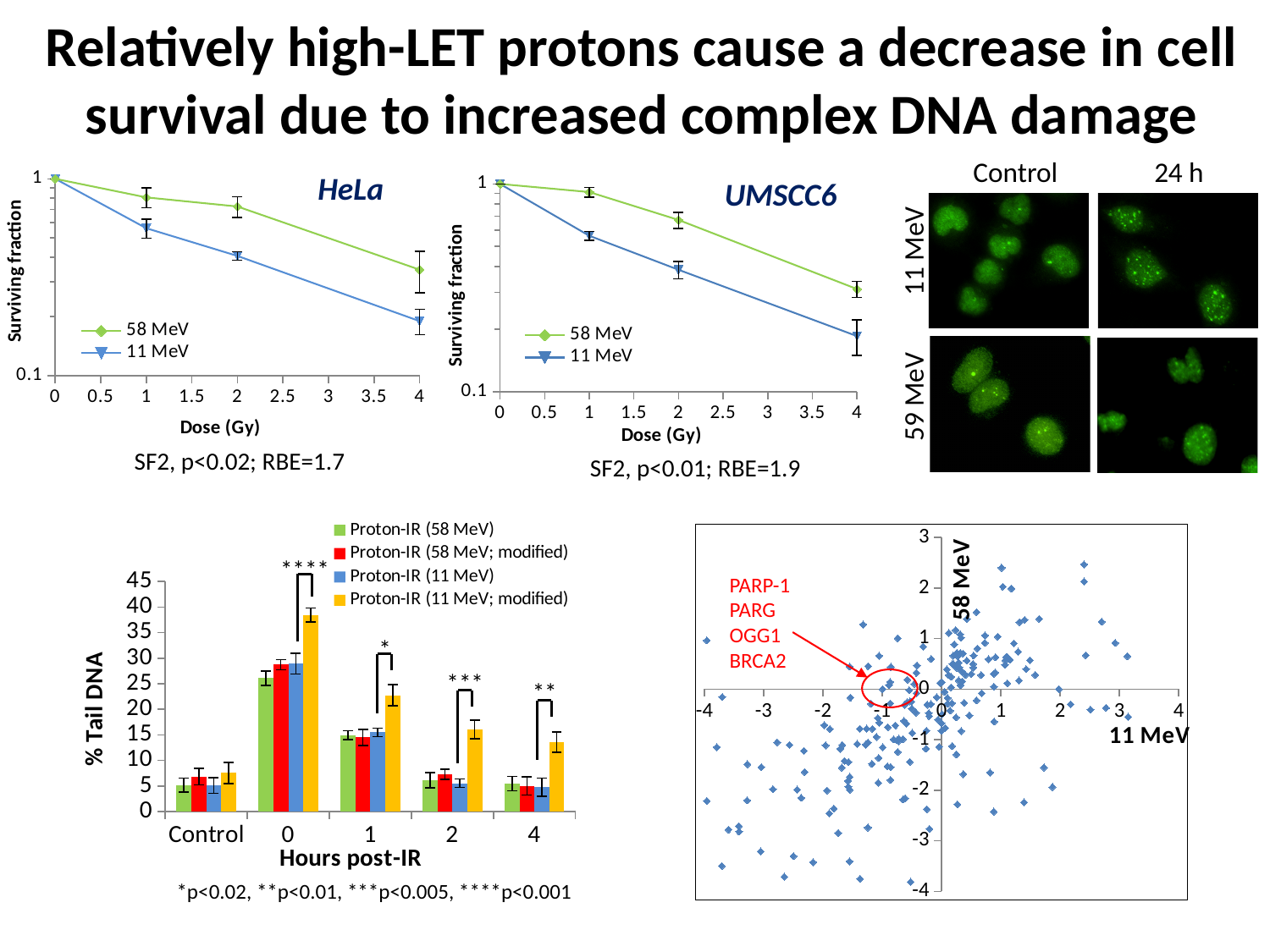
In the UMSCC6 chart, at a dose of 2 Gy, which series has the lower surviving fraction, 58 MeV or 11 MeV? 11 MeV In the % Tail DNA bar chart, which series has the highest bar at 0 hours post-IR? Proton-IR (11 MeV; modified) What kind of chart is the HeLa chart at the top left? Line chart In the HeLa chart, at a dose of 4 Gy, which series has the higher surviving fraction, 58 MeV or 11 MeV? 58 MeV How many series does the legend of the % Tail DNA bar chart list? 4 In the UMSCC6 chart, is the surviving fraction for 11 MeV at 4 Gy greater or less than 1? less What kind of chart is the % Tail DNA chart at the bottom left? Bar chart How many series does the legend of the HeLa chart list? 2 What kind of chart is the chart at the bottom right with axes labelled 58 MeV and 11 MeV? Scatter plot In the HeLa chart, does the surviving fraction rise or fall as the dose increases? Fall How many categories are shown on the x axis of the % Tail DNA bar chart? 5 In the % Tail DNA bar chart, is the value for Proton-IR (11 MeV; modified) at 0 hours post-IR greater or less than 35? greater